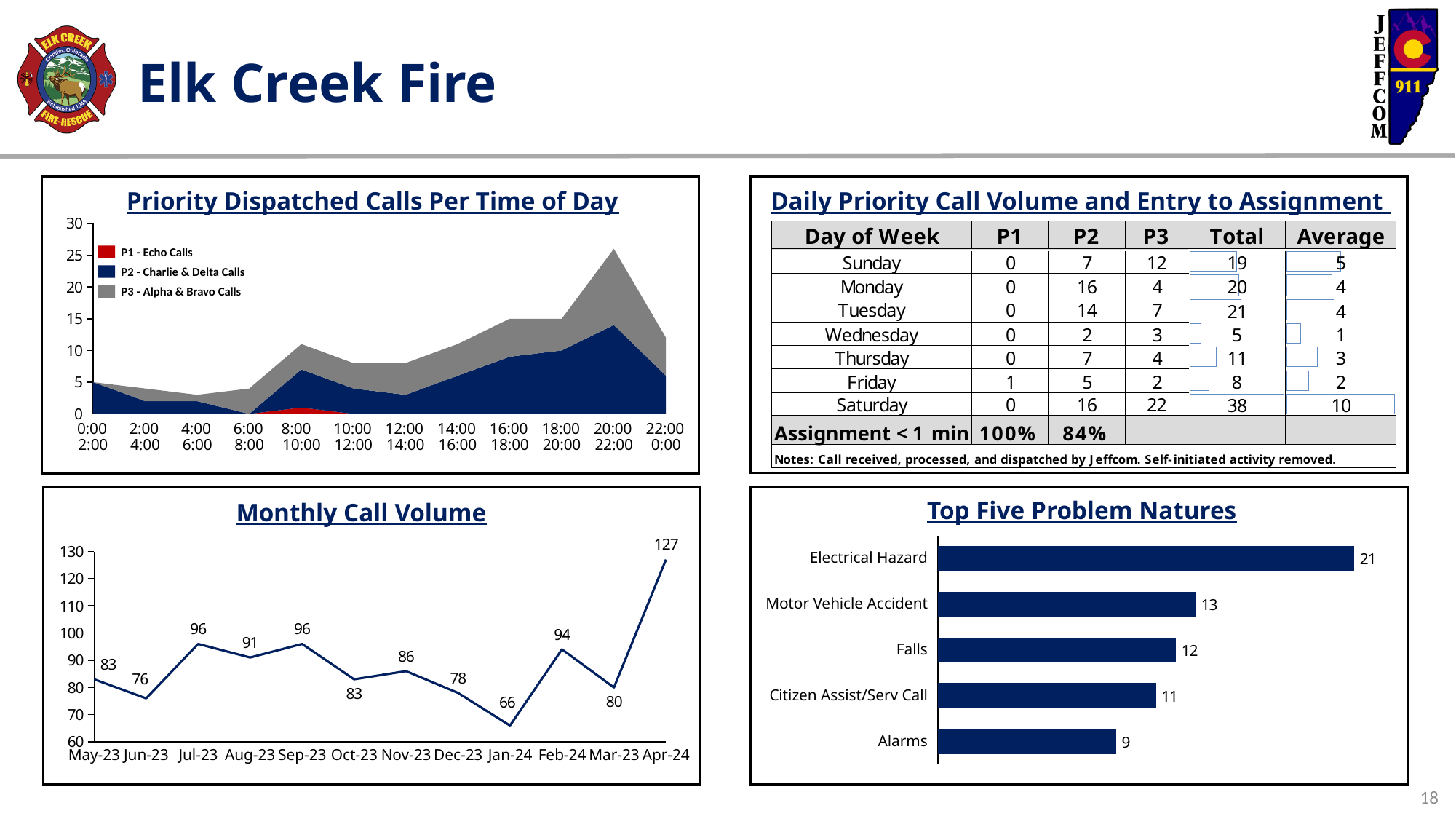
In the Priority Dispatched Calls Per Time of Day chart, is the total value for the 20:00-22:00 period greater or less than 20? greater In the Monthly Call Volume chart, how many months are plotted? 12 In the Priority Dispatched Calls Per Time of Day chart, how many series does the legend list? 3 In the Monthly Call Volume chart, which month has the lowest call volume? Jan-24 What kind of chart is the Monthly Call Volume chart? Line chart What kind of chart is the Top Five Problem Natures chart? Bar chart In the Monthly Call Volume chart, what is the value for Apr-24? 127 In the Monthly Call Volume chart, what is the difference between the values for Apr-24 and Jan-24? 61 In the Monthly Call Volume chart, which is larger, the value for Feb-24 or the value for Aug-23? Feb-24 In the Top Five Problem Natures chart, which problem nature has the highest value? Electrical Hazard In the Top Five Problem Natures chart, what is the value for Falls? 12 In the Top Five Problem Natures chart, what is the difference between Electrical Hazard and Motor Vehicle Accident? 8